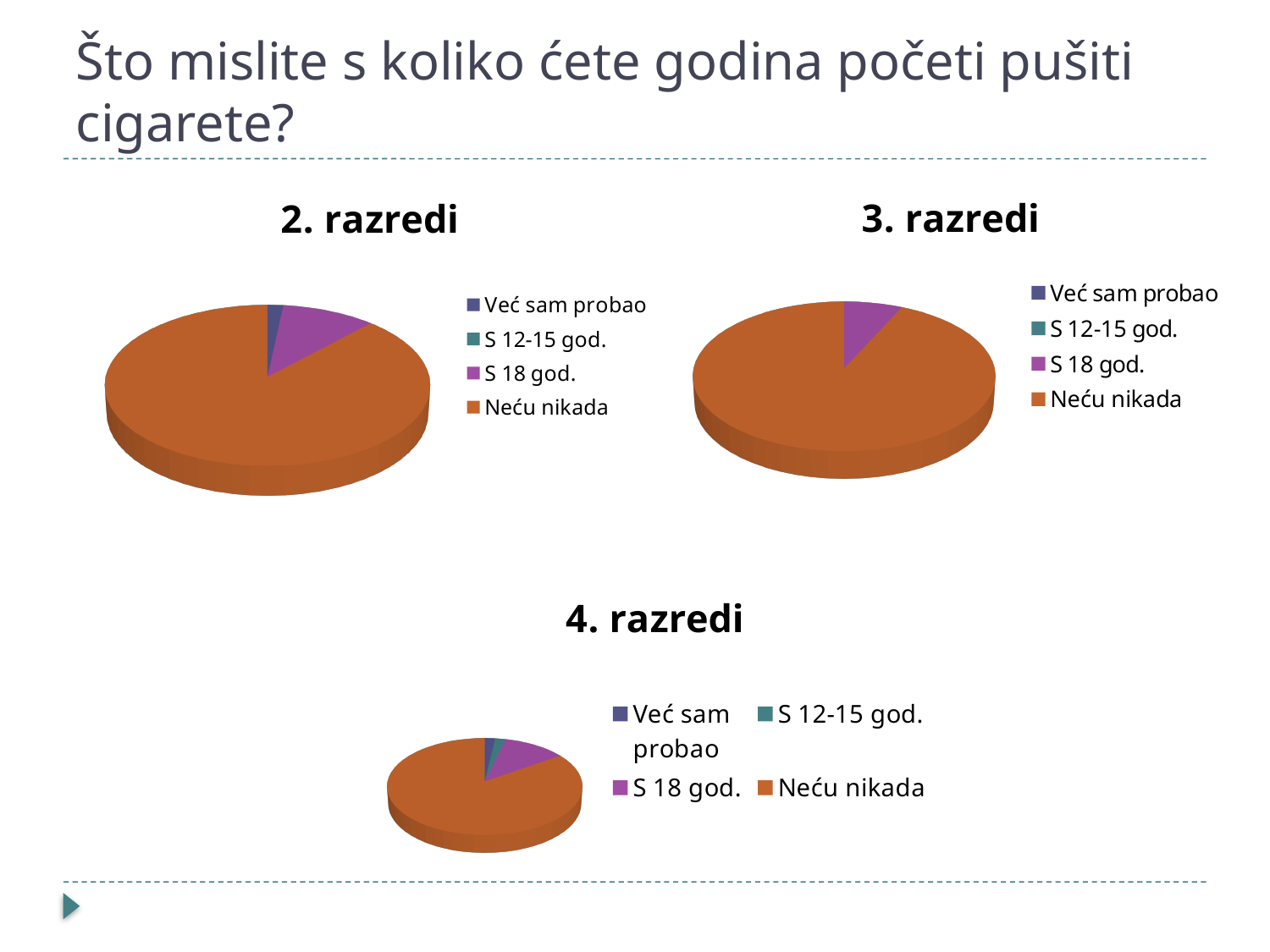
In the "2. razredi" chart, what colour is the slice for "Neću nikada"? orange In the "4. razredi" chart, which is larger, the slice for "Neću nikada" or the slice for "S 18 god."? Neću nikada What kind of chart is the "4. razredi" chart? pie chart In the "2. razredi" chart, which is larger, the slice for "S 18 god." or the slice for "Već sam probao"? S 18 god. What is the title of the pie chart at the bottom of the slide? 4. razredi How many entries does the legend of the "3. razredi" chart list? 4 What kind of chart is the "2. razredi" chart? pie chart In the "2. razredi" chart, which category has the largest slice? Neću nikada How many pie charts are shown on the slide? 3 In the "3. razredi" chart, which category has the largest slice? Neću nikada In the "4. razredi" chart, which category has the largest slice? Neću nikada How many entries does the legend of the "4. razredi" chart list? 4